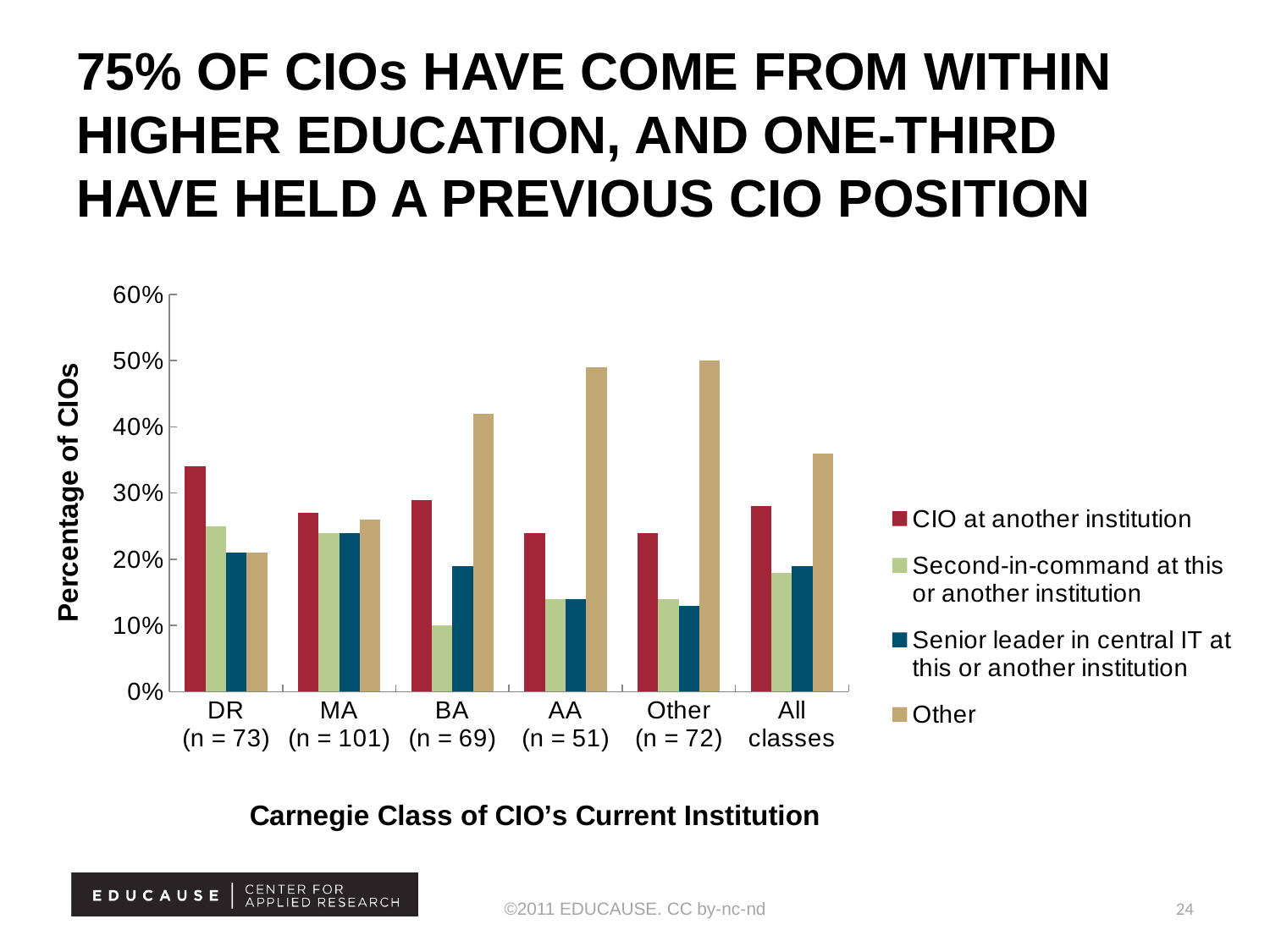
What is the label of the vertical axis? Percentage of CIOs Which series has the lowest value for the BA (n = 69) category? Second-in-command at this or another institution Is the value for CIO at another institution in the DR (n = 73) category greater or less than 30%? greater Is the value for Other in the AA (n = 51) category greater or less than 40%? greater Which series has the highest value for the AA (n = 51) category? Other How many Carnegie class categories are shown along the x axis? 6 What is the label of the horizontal axis? Carnegie Class of CIO's Current Institution Which is larger: the Other value for BA (n = 69) or the Other value for DR (n = 73)? BA (n = 69) How many series does the legend list? 4 Is the value for Second-in-command at this or another institution in the BA (n = 69) category greater or less than 20%? less Which series has the highest value for the DR (n = 73) category? CIO at another institution What kind of chart is shown on the slide? bar chart